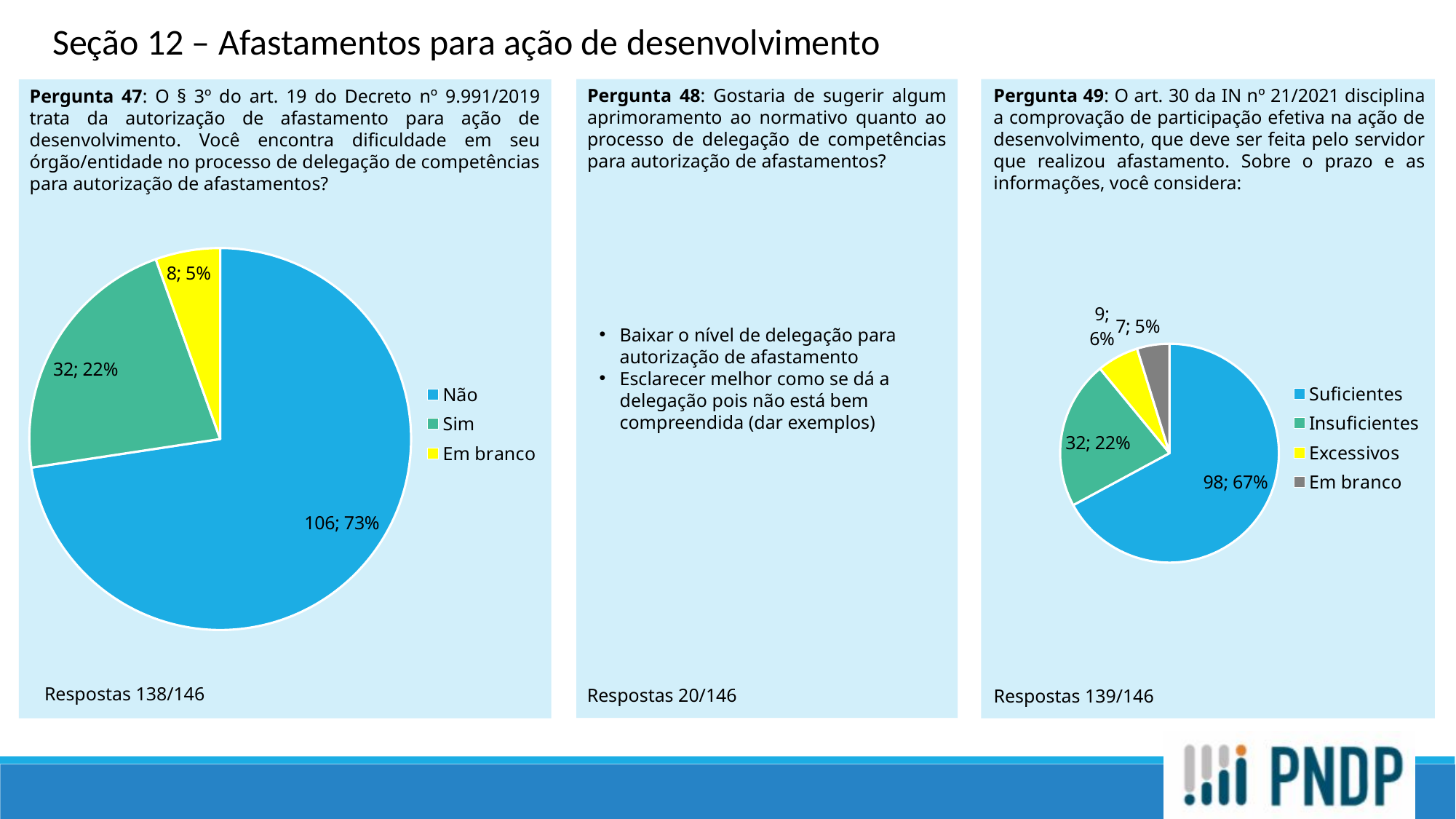
In the Pergunta 49 pie chart on the right, which category has the largest slice? Suficientes In the Pergunta 49 pie chart on the right, what percentage share does "Excessivos" have? 6% In the Pergunta 49 pie chart on the right, what colour is the "Em branco" slice? Grey How many categories does the legend of the Pergunta 49 pie chart on the right list? 4 In the Pergunta 47 pie chart on the left, what percentage share does "Sim" have? 22% How many categories does the legend of the Pergunta 47 pie chart on the left list? 3 In the Pergunta 49 pie chart on the right, how many responses are labelled for "Suficientes"? 98 In the Pergunta 49 pie chart on the right, which is larger, "Insuficientes" or "Em branco"? Insuficientes What type of chart is used for Pergunta 49 on the right? Pie chart In the Pergunta 47 pie chart on the left, which category has the smallest slice? Em branco In the Pergunta 47 pie chart on the left, what is the difference in count between "Não" and "Sim"? 74 In the Pergunta 47 pie chart on the left, how many responses are labelled for "Não"? 106